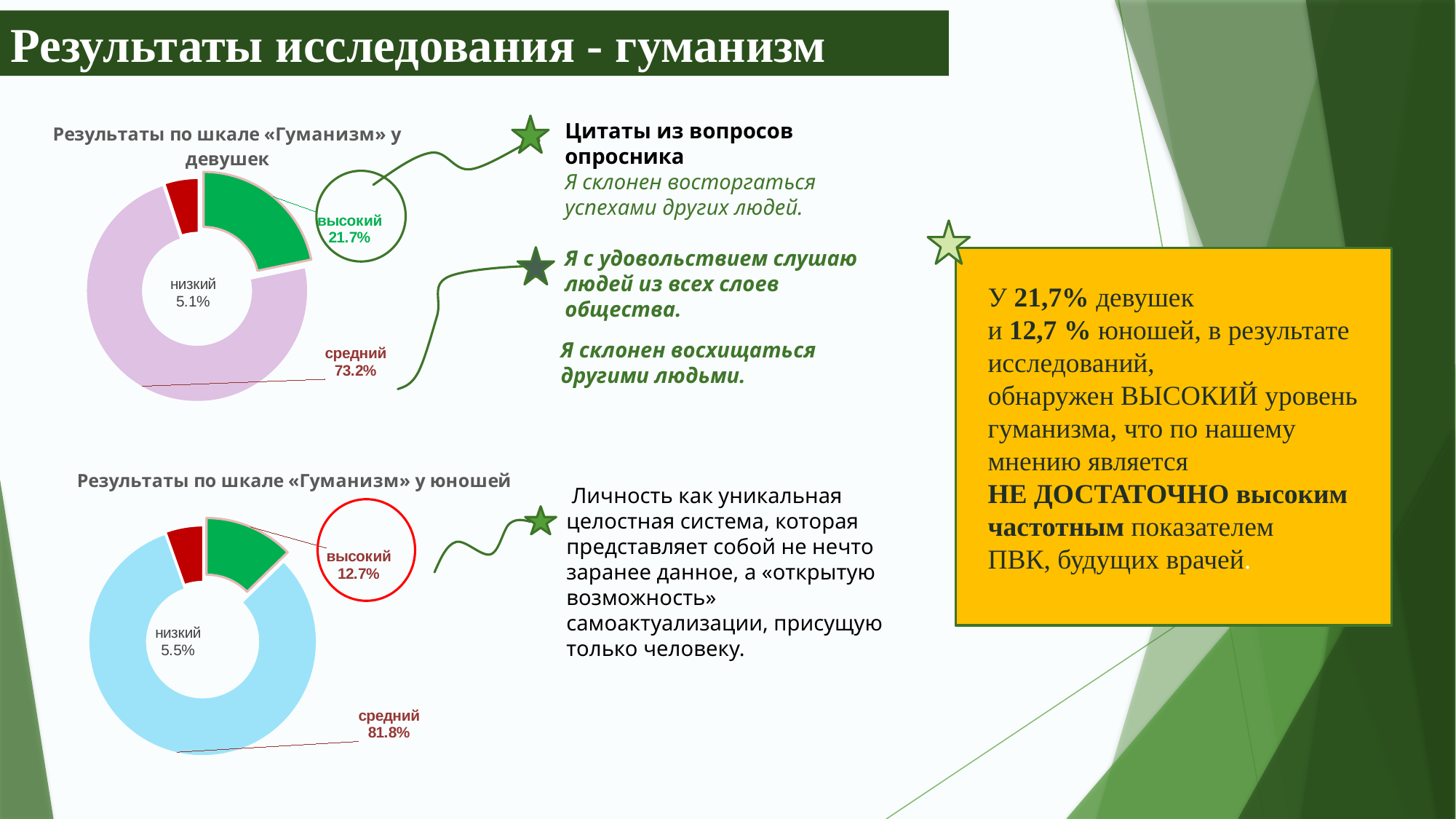
In the chart «Результаты по шкале «Гуманизм» у юношей», what is the difference between «высокий» and «низкий»? 7.2% What colour is the «высокий» segment in the chart «Результаты по шкале «Гуманизм» у девушек»? Green In the chart «Результаты по шкале «Гуманизм» у девушек», what is the value for «средний»? 73.2% In the chart «Результаты по шкале «Гуманизм» у девушек», which category has the largest share? средний Which is larger: «высокий» in the chart for девушек or «высокий» in the chart for юношей? девушек (21.7%) What type of chart is «Результаты по шкале «Гуманизм» у девушек»? Doughnut (pie) chart In the chart «Результаты по шкале «Гуманизм» у юношей», what is the value for «низкий»? 5.5% In the chart «Результаты по шкале «Гуманизм» у юношей», which category has the smallest share? низкий In the chart «Результаты по шкале «Гуманизм» у девушек», what is the value for «высокий»? 21.7% How many categories does the chart «Результаты по шкале «Гуманизм» у юношей» show? 3 In the chart «Результаты по шкале «Гуманизм» у девушек», what is the difference between «средний» and «высокий»? 51.5% In the chart «Результаты по шкале «Гуманизм» у юношей», what is the value for «средний»? 81.8%